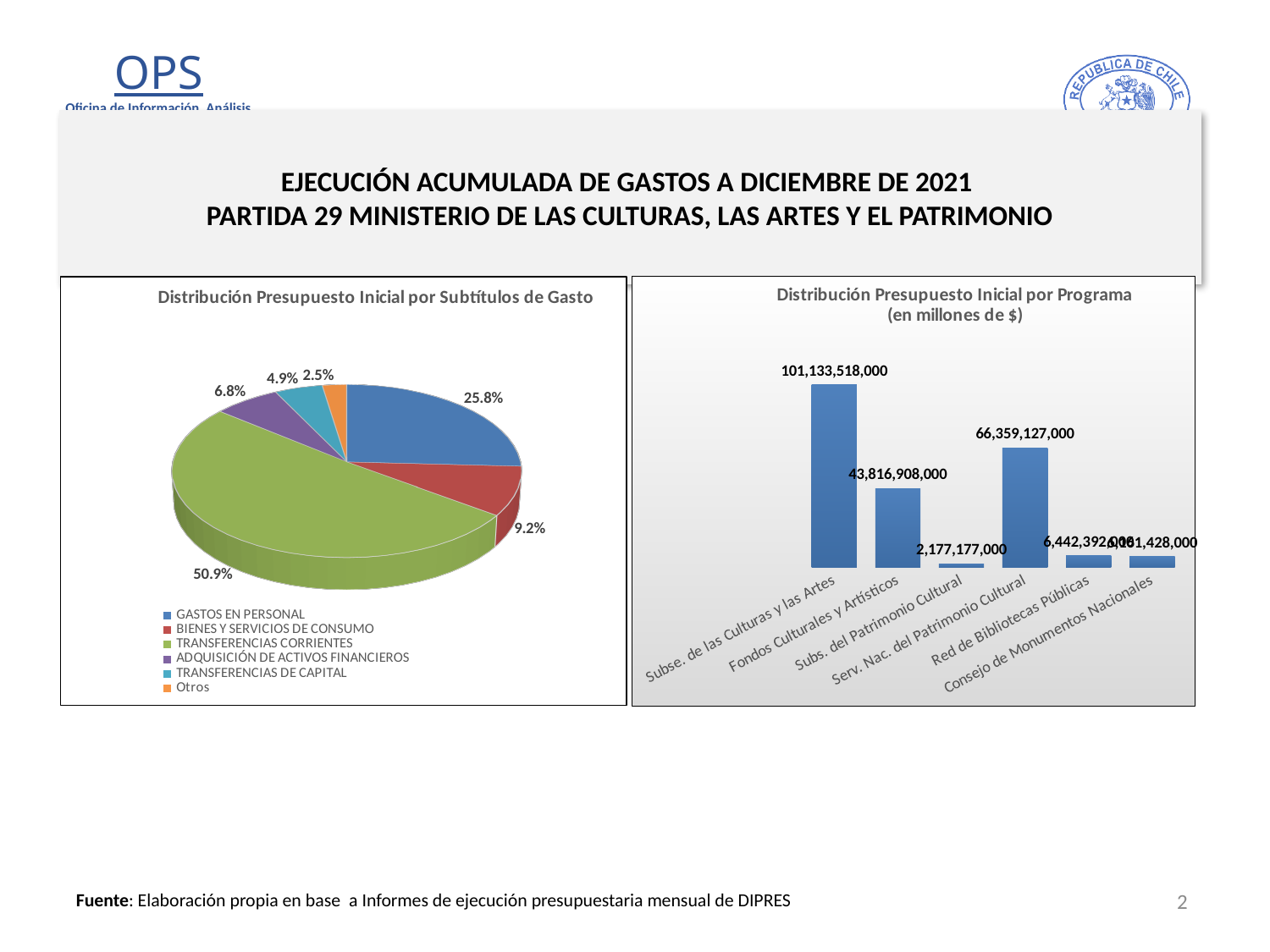
In the chart 'Distribución Presupuesto Inicial por Programa', what is the value for Serv. Nac. del Patrimonio Cultural? 66,359,127,000 In the chart 'Distribución Presupuesto Inicial por Subtítulos de Gasto', which category has the smallest slice? Otros What kind of chart is 'Distribución Presupuesto Inicial por Programa'? Bar chart In the chart 'Distribución Presupuesto Inicial por Subtítulos de Gasto', what share does TRANSFERENCIAS CORRIENTES have? 50.9% How many entries does the legend of the chart 'Distribución Presupuesto Inicial por Subtítulos de Gasto' list? 6 In the chart 'Distribución Presupuesto Inicial por Programa', what is the value for Subse. de las Culturas y las Artes? 101,133,518,000 In the chart 'Distribución Presupuesto Inicial por Subtítulos de Gasto', what is the difference between the shares of GASTOS EN PERSONAL and BIENES Y SERVICIOS DE CONSUMO? 16.6% In the chart 'Distribución Presupuesto Inicial por Subtítulos de Gasto', what share does GASTOS EN PERSONAL have? 25.8% In the chart 'Distribución Presupuesto Inicial por Programa', which is larger: Fondos Culturales y Artísticos or Serv. Nac. del Patrimonio Cultural? Serv. Nac. del Patrimonio Cultural What kind of chart is 'Distribución Presupuesto Inicial por Subtítulos de Gasto'? Pie chart In the chart 'Distribución Presupuesto Inicial por Subtítulos de Gasto', which category has the largest slice? TRANSFERENCIAS CORRIENTES In the chart 'Distribución Presupuesto Inicial por Programa', which program has the lowest value? Subs. del Patrimonio Cultural